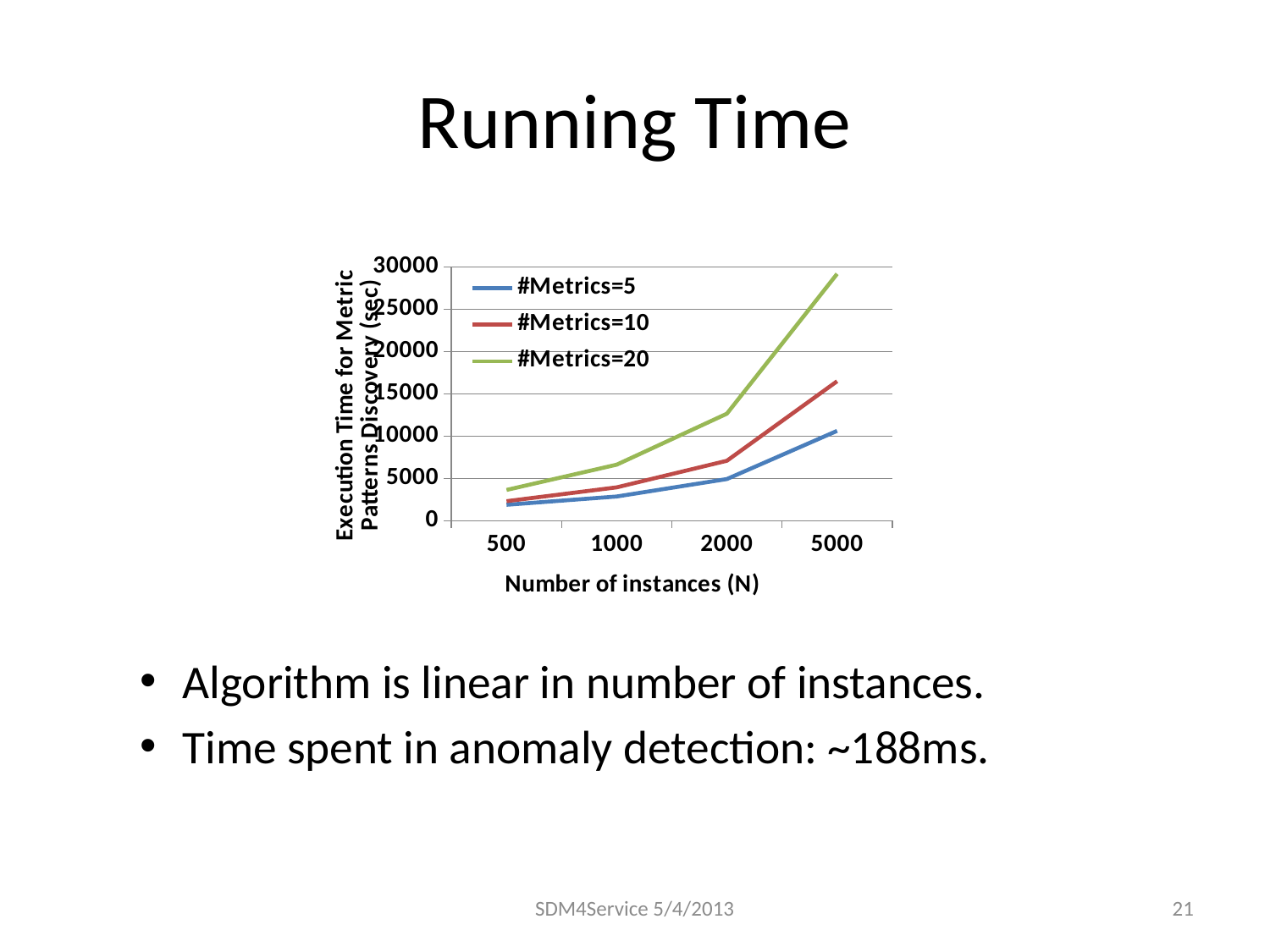
Is the execution time for #Metrics=10 at N=5000 greater or less than 15000? greater Is the execution time for #Metrics=5 at N=5000 greater or less than 15000? less What is the title of the x axis? Number of instances (N) Does the execution time for #Metrics=20 rise or fall as the number of instances increases? rise What kind of chart is shown on the slide? line chart How many values of N are plotted along the x axis? 4 Is the execution time for #Metrics=20 at N=2000 greater or less than 10000? greater Which series has the highest execution time at N=5000? #Metrics=20 At N=1000, which series has the larger execution time, #Metrics=20 or #Metrics=5? #Metrics=20 Which series has the lowest execution time at N=5000? #Metrics=5 How many series does the legend list? 3